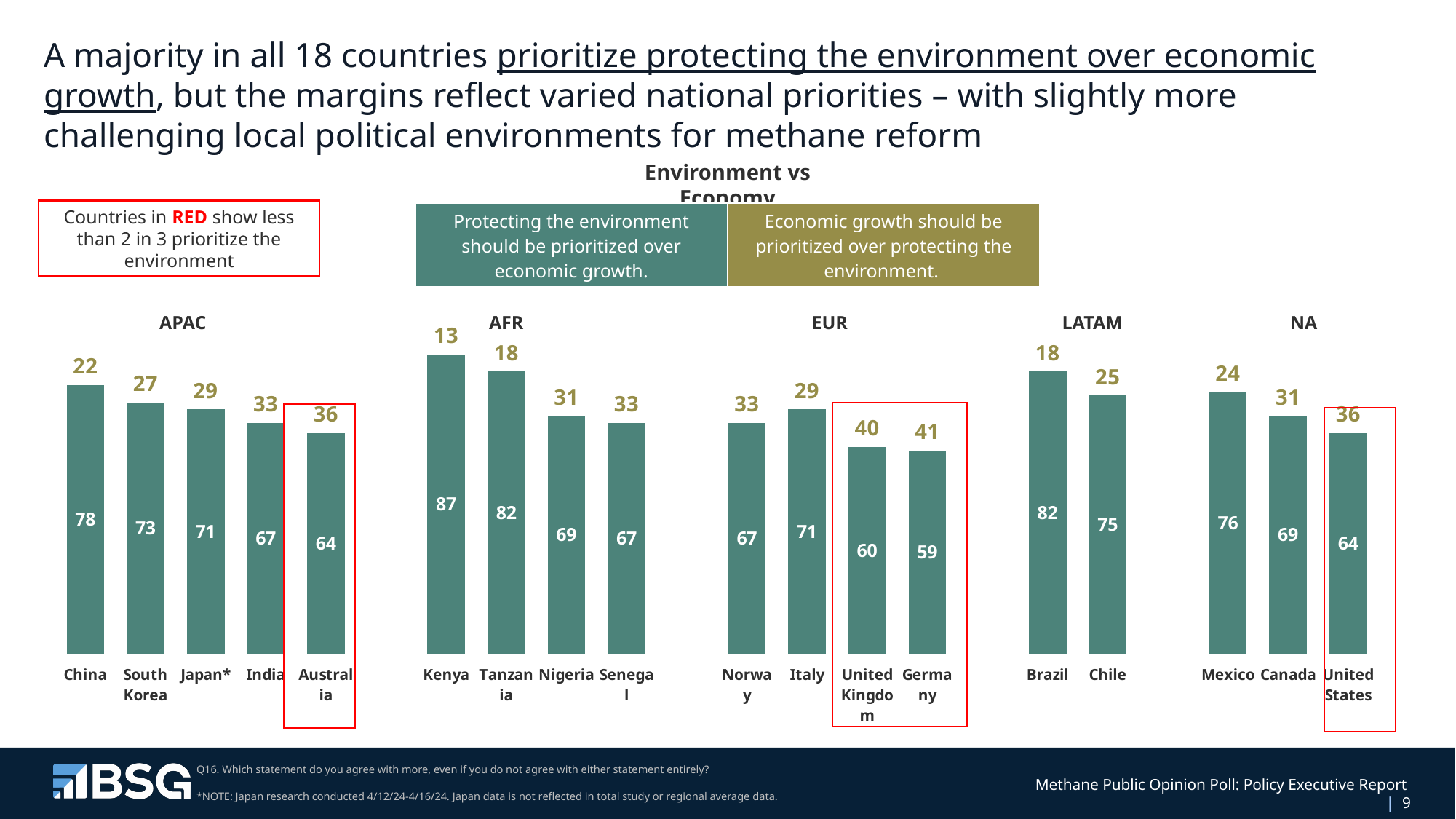
In the EUR chart, what is the value for the United Kingdom for economic growth being prioritized? 40 In the APAC chart, do the values for prioritizing the environment rise or fall from China to Australia? Fall According to the legend, what does the gold colour represent? Economic growth should be prioritized over protecting the environment. What kind of chart is used to show the Environment vs Economy results? Bar chart In the EUR chart, which country has the lowest value for prioritizing the environment? Germany In the NA chart, which is larger: Mexico's or Canada's value for prioritizing the environment? Mexico In the APAC chart, what percentage in China say protecting the environment should be prioritized over economic growth? 78 In the AFR chart, what is the value shown above the Kenya bar for economic growth being prioritized? 13 How many countries are shown in the APAC chart? 5 In the AFR chart, which country has the highest value for prioritizing the environment? Kenya In the LATAM chart, what is the difference between Brazil's and Chile's values for prioritizing the environment? 7 In the NA chart, what is the value for the United States for prioritizing the environment? 64